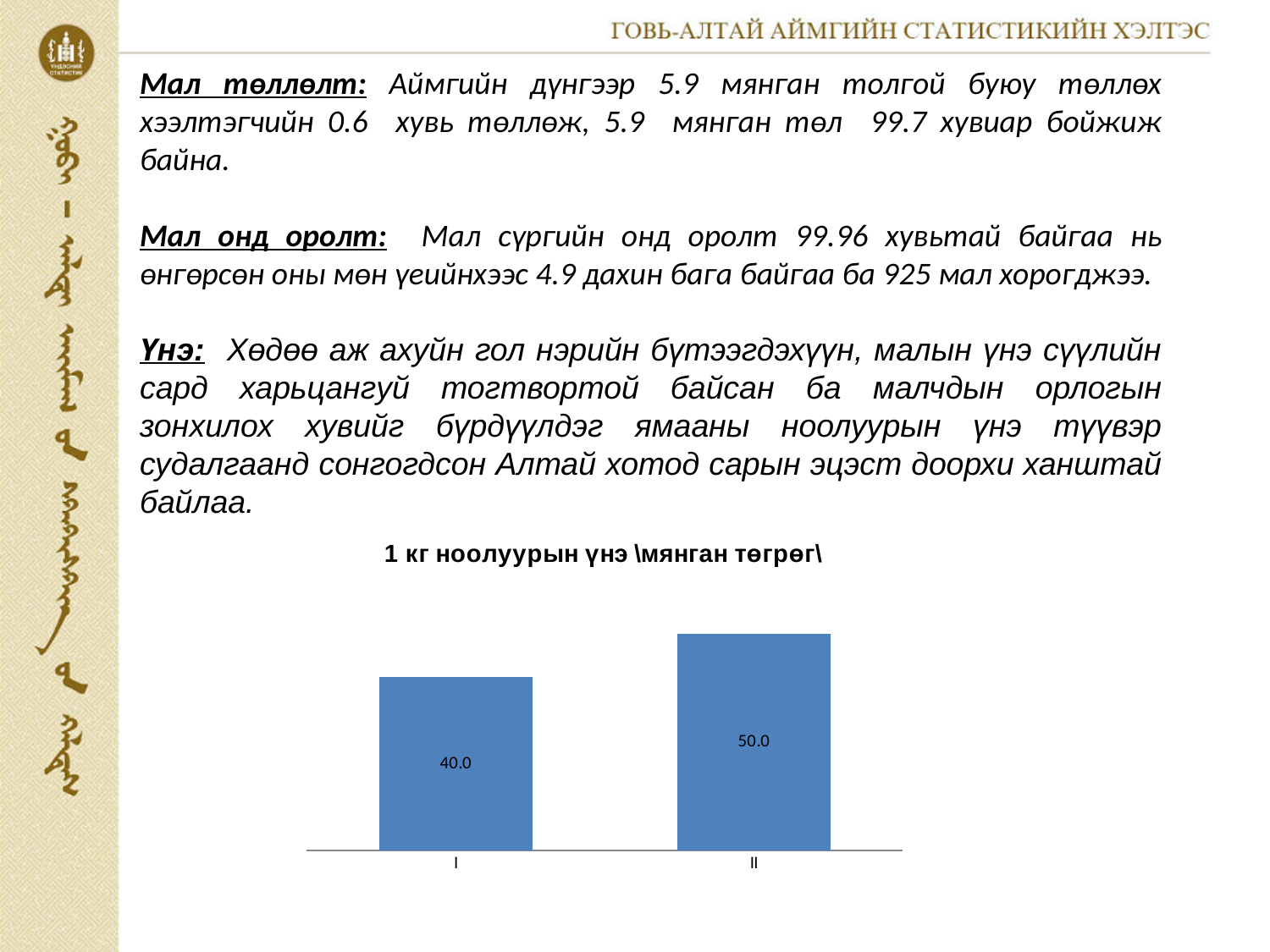
Do the values rise or fall from category I to category II? rise What is the value for category II in the chart? 50.0 Which is larger, the value for I or the value for II? II Which category has the lowest value in the chart? I Which category has the highest value in the chart? II What kind of chart is shown on the slide? bar chart What is the title of the chart? 1 кг ноолуурын үнэ \мянган төгрөг\ What is the value for category I in the chart? 40.0 How many categories are shown in the chart? 2 What is the difference between the values for II and I? 10.0 What colour are the bars in the chart? blue